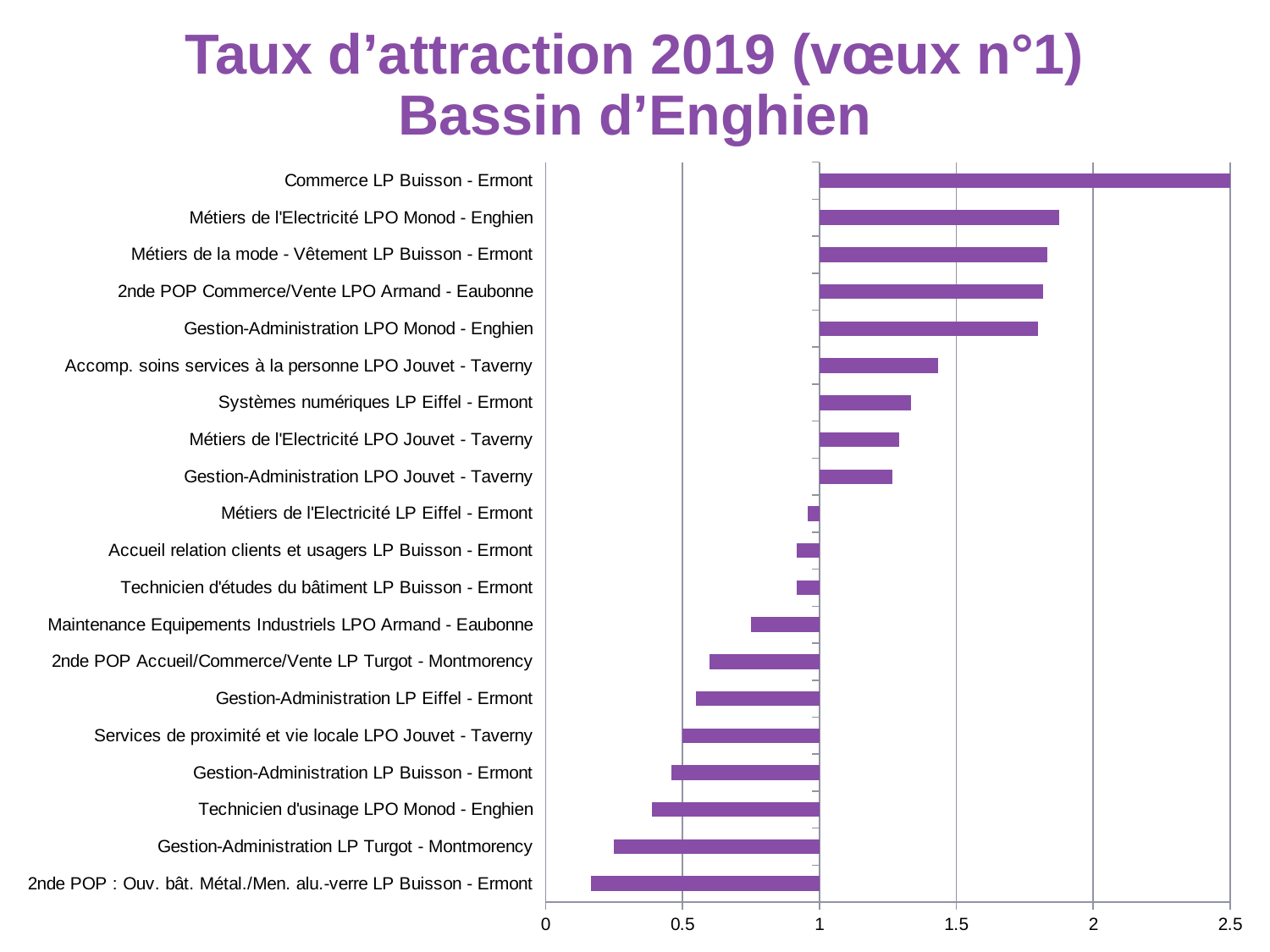
Which has the larger attraction rate: Métiers de l'Electricité LPO Jouvet - Taverny or Métiers de l'Electricité LP Eiffel - Ermont? Métiers de l'Electricité LPO Jouvet - Taverny Which category has the lowest attraction rate? 2nde POP : Ouv. bât. Métal./Men. alu.-verre LP Buisson - Ermont Is the value for Technicien d'usinage LPO Monod - Enghien greater or less than 0.5? less What is the title of the slide? Taux d'attraction 2019 (vœux n°1) Bassin d'Enghien Is the value for Accomp. soins services à la personne LPO Jouvet - Taverny greater or less than 1? greater Is the value for Métiers de l'Electricité LPO Monod - Enghien greater or less than 2? less What kind of chart is shown on the slide? bar chart Which category has the highest attraction rate? Commerce LP Buisson - Ermont What is the attraction rate for Commerce LP Buisson - Ermont? 2.5 Which has the larger attraction rate: Gestion-Administration LPO Monod - Enghien or Gestion-Administration LPO Jouvet - Taverny? Gestion-Administration LPO Monod - Enghien How many categories (training programmes) are plotted in the chart? 20